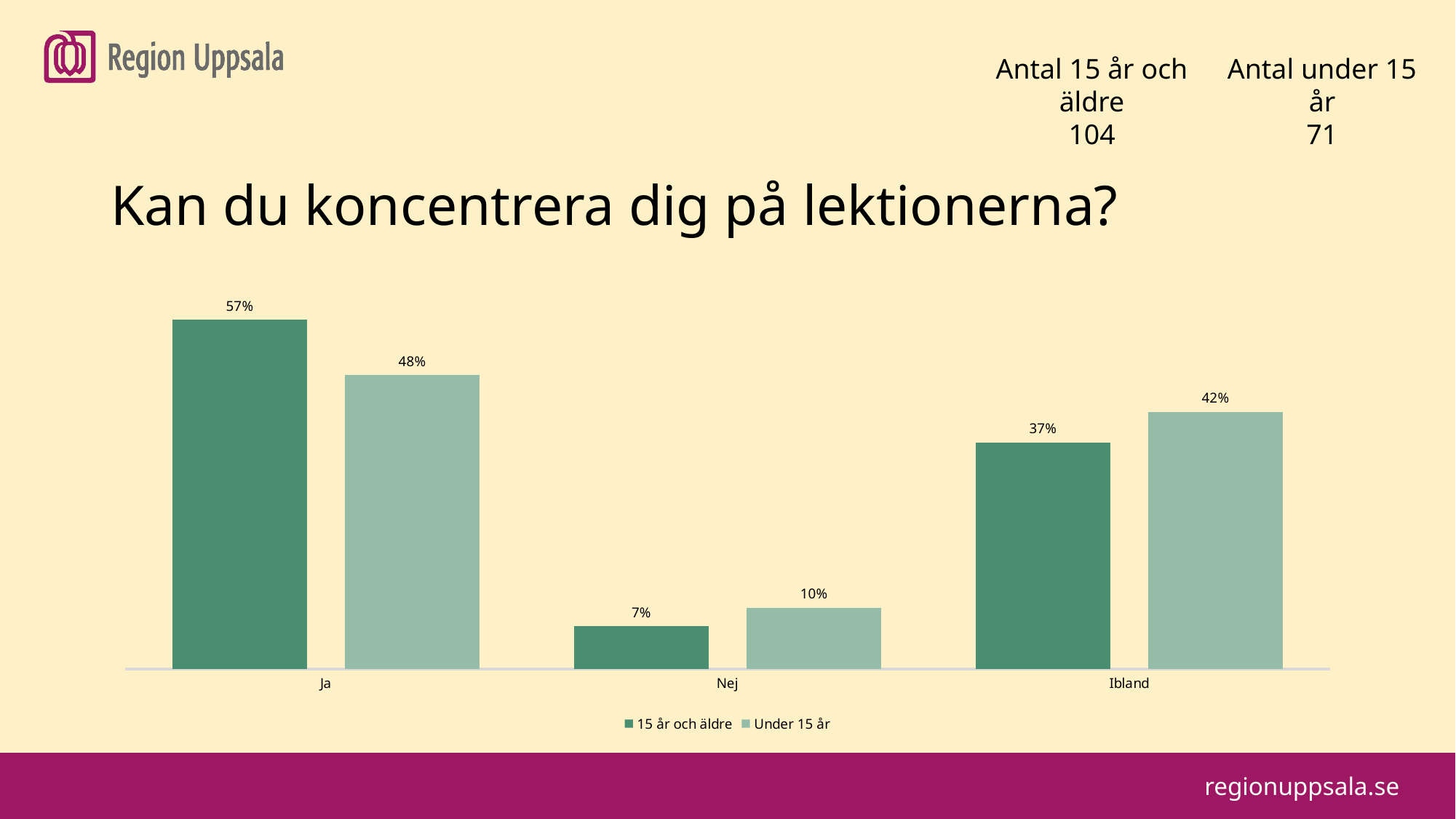
In the "Ibland" category, which series has the larger value? Under 15 år How many categories are shown on the x axis? 3 Which category has the lowest value for the "Under 15 år" series? Nej What is the value for "Under 15 år" in the "Ibland" category? 42% What kind of chart is shown on the slide? Bar chart What is the value for "Under 15 år" in the "Nej" category? 10% What is the title of the chart on the slide? Kan du koncentrera dig på lektionerna? What is the difference between the "15 år och äldre" and "Under 15 år" values in the "Ja" category? 9% What is the difference between the "Under 15 år" and "15 år och äldre" values in the "Ibland" category? 5% How many series does the legend list? 2 Which category has the highest value for the "15 år och äldre" series? Ja What is the value for "15 år och äldre" in the "Ja" category? 57%